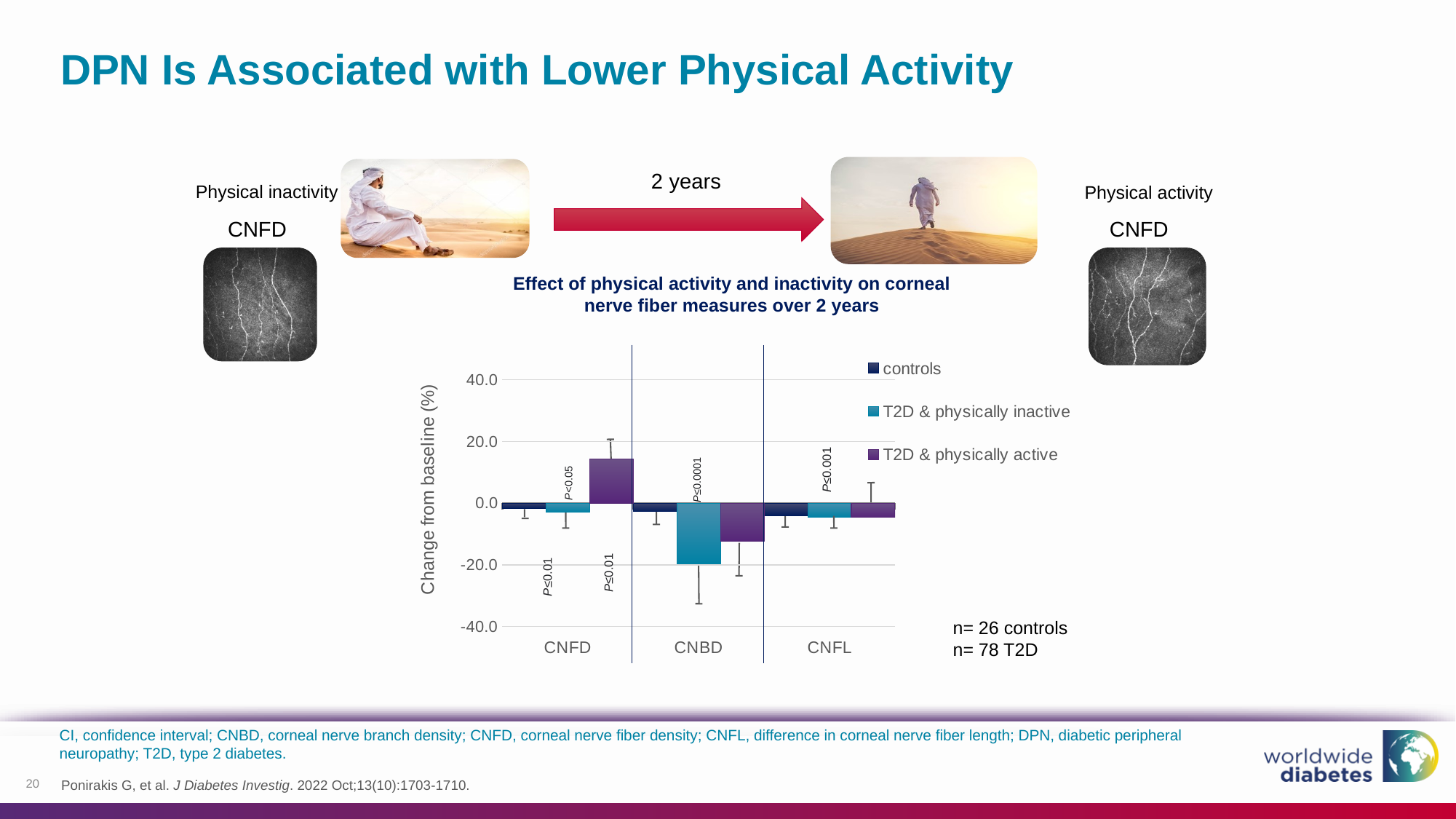
In the CNFD category, which is larger: the value for T2D & physically inactive or T2D & physically active? T2D & physically active Is the value for T2D & physically active in the CNFD category greater or less than 20.0? less What is the label of the chart's y axis? Change from baseline (%) How many series does the chart legend list? 3 Which category has the lowest value for the T2D & physically inactive series? CNBD Is the value for T2D & physically active in the CNBD category greater or less than -20.0? greater What kind of chart is shown on the slide? bar chart What is the title of the chart? Effect of physical activity and inactivity on corneal nerve fiber measures over 2 years How many categories are shown on the x axis of the chart? 3 Is the value for T2D & physically inactive in the CNBD category greater or less than 0.0? less Which category has the highest value for the T2D & physically active series? CNFD